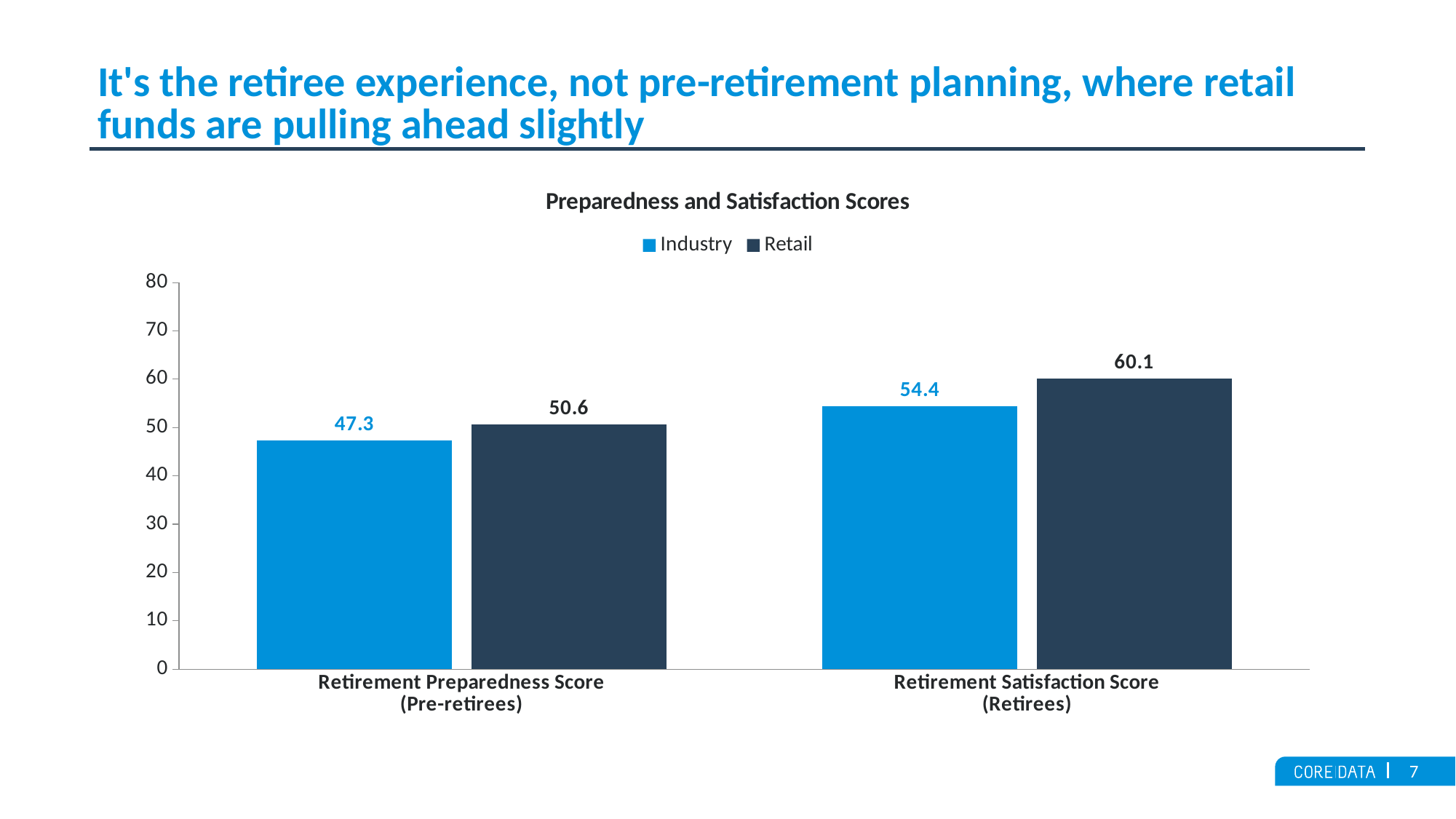
What is the Retail value for Retirement Preparedness Score (Pre-retirees)? 50.6 Which bar has the lowest value on the chart? Industry, Retirement Preparedness Score (Pre-retirees) What is the Retail value for Retirement Satisfaction Score (Retirees)? 60.1 What is the Industry value for Retirement Satisfaction Score (Retirees)? 54.4 What is the difference between the Retail and Industry values for Retirement Satisfaction Score (Retirees)? 5.7 How many categories are shown on the x axis? 2 What is the difference between the Retail and Industry values for Retirement Preparedness Score (Pre-retirees)? 3.3 How many series does the legend list? 2 Which is larger: the Industry value for Retirement Satisfaction Score (Retirees) or the Retail value for Retirement Preparedness Score (Pre-retirees)? Industry value for Retirement Satisfaction Score (Retirees) Which series has the highest value for Retirement Satisfaction Score (Retirees)? Retail What is the Industry value for Retirement Preparedness Score (Pre-retirees)? 47.3 What type of chart is shown on the slide? Bar chart